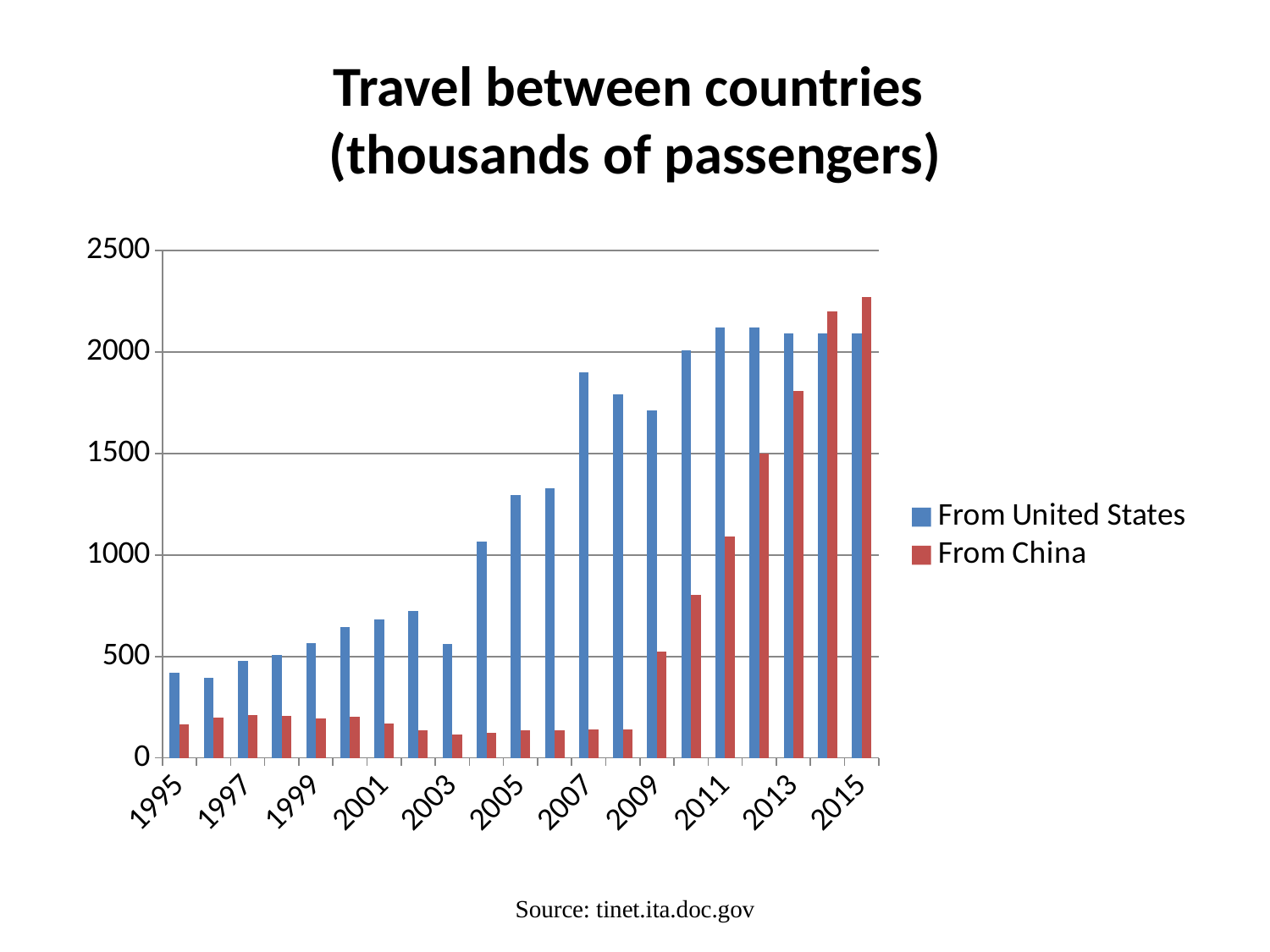
Does the From China series rise or fall from 2009 to 2015? rise Is the From United States value for 1995 greater or less than 500? less Is the From United States value for 2007 greater or less than 1500? greater In which year is the From China value highest? 2015 What kind of chart is shown on the slide? bar chart What is the title of the chart? Travel between countries (thousands of passengers) How many series does the legend list? 2 Which series has the higher value in 2015, From United States or From China? From China What are the two series named in the legend? From United States; From China Is the From China value for 2013 greater or less than 1500? greater Which series has the higher value in 2007, From United States or From China? From United States